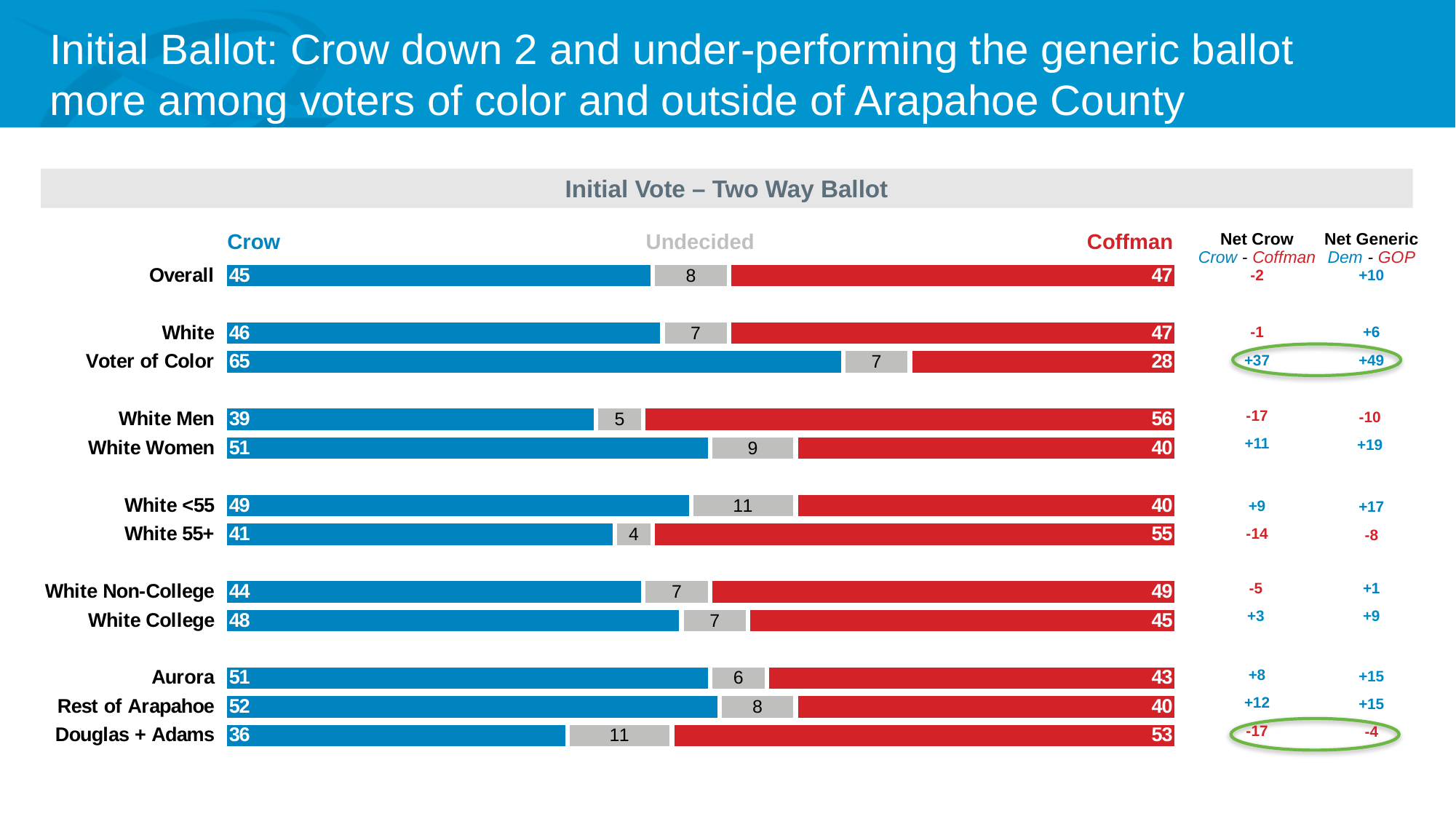
What is the difference between the Coffman and Crow values for Overall? 2 What is the total of the stacked bar for White Women? 100 What kind of chart is this? Stacked bar chart Which category has the highest Crow value? Voter of Color Which category has the lowest Crow value? Douglas + Adams Is the Crow value larger for Aurora or for Douglas + Adams? Aurora What is the Coffman value for White Men? 56 How many categories are shown in the chart? 13 How many series does the chart show? 3 What is the Undecided value for White <55? 11 What is the title of the chart? Initial Vote – Two Way Ballot What is the Crow value for Voter of Color? 65